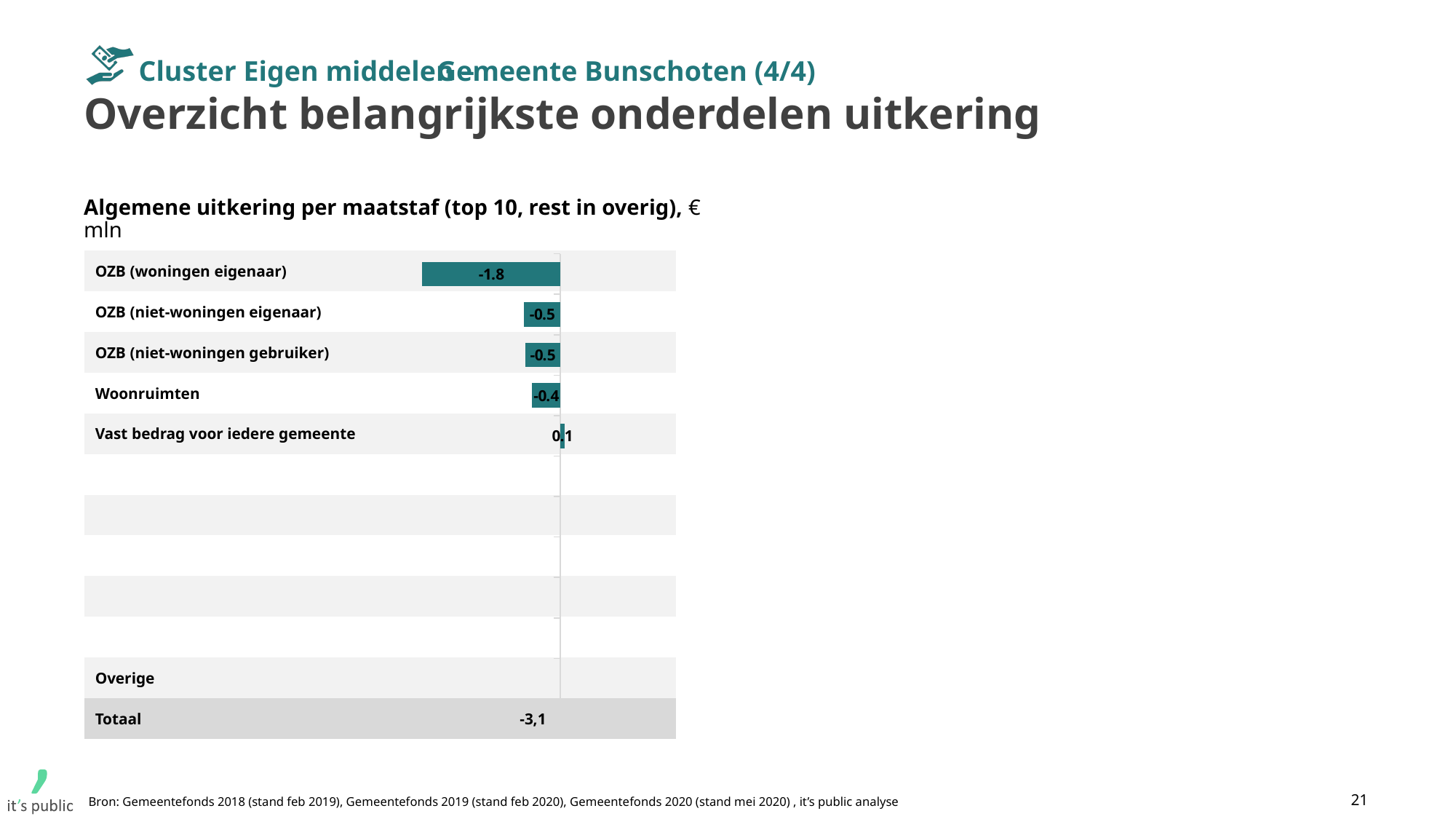
How many categories have a plotted bar with a data label? 5 What is the title of the chart? Algemene uitkering per maatstaf (top 10, rest in overig), € mln What is the value shown for Totaal? -3,1 What is the value for Vast bedrag voor iedere gemeente? 0.1 What is the value for OZB (woningen eigenaar)? -1.8 Which is larger, the value for Woonruimten or the value for OZB (niet-woningen gebruiker)? Woonruimten Which category has the lowest value? OZB (woningen eigenaar) What kind of chart is shown on the slide? Bar chart What is the value for OZB (niet-woningen eigenaar)? -0.5 What is the difference between the values for OZB (woningen eigenaar) and Woonruimten? 1.4 What is the value for Woonruimten? -0.4 Which category has the highest value? Vast bedrag voor iedere gemeente